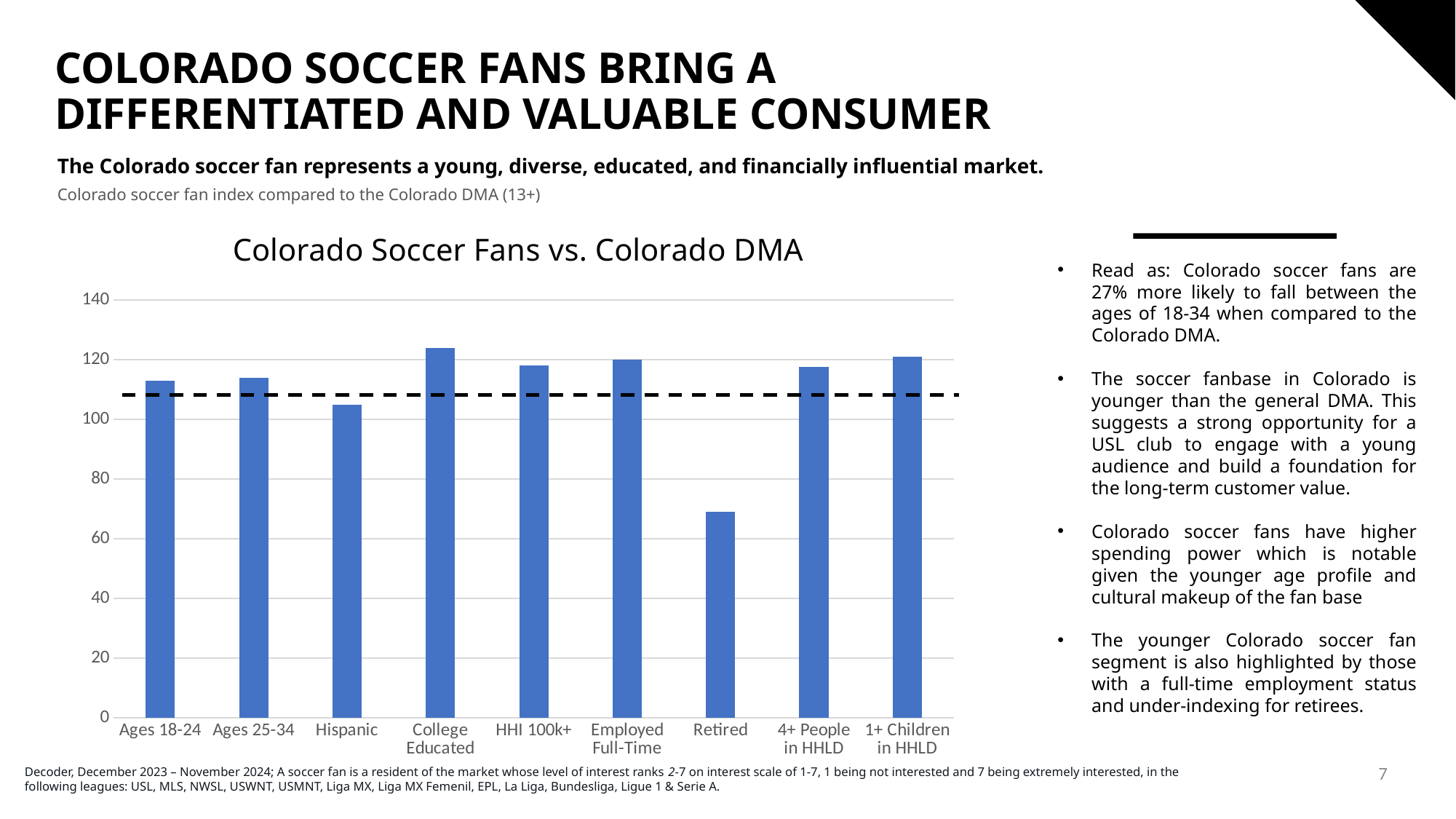
Is the value for Retired greater or less than 80? less How many categories are plotted on the x axis of the chart? 9 Is the value for Hispanic greater or less than 100? greater What type of chart is shown on the slide? Bar chart Which is larger, the value for College Educated or the value for Hispanic? College Educated Is the value for College Educated greater or less than 120? greater What is the title of the chart? Colorado Soccer Fans vs. Colorado DMA Which is larger, the value for Hispanic or the value for Retired? Hispanic What is the highest value shown on the chart's vertical axis? 140 Which category has the lowest value in the chart? Retired